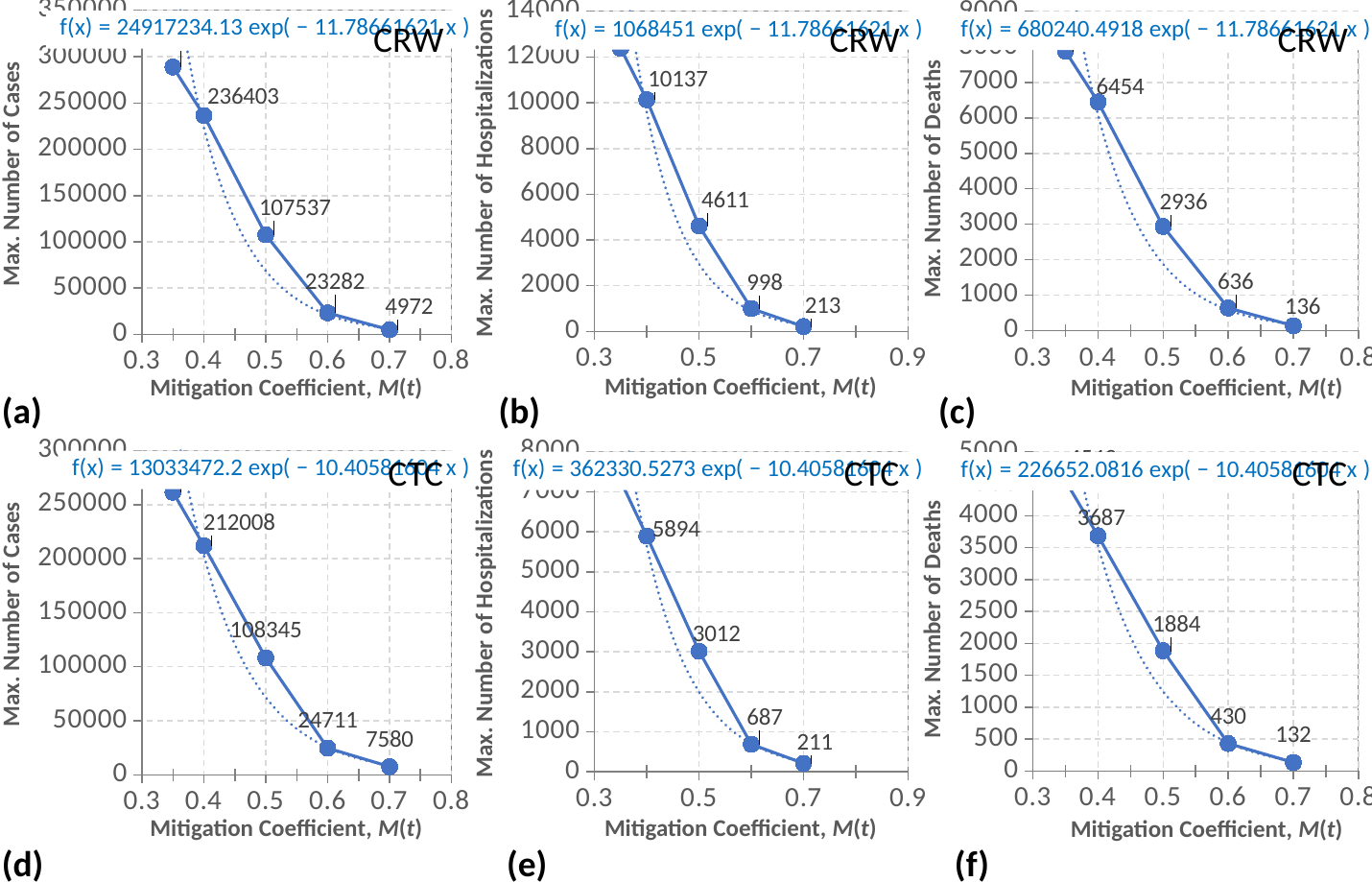
In chart (c), the CRW Max. Number of Deaths chart, what is the value at mitigation coefficient 0.7? 136 In chart (a), the CRW Max. Number of Cases chart, is the value at mitigation coefficient 0.35 greater or less than 250000? greater In chart (c), the CRW Max. Number of Deaths chart, what is the difference between the values at mitigation coefficients 0.4 and 0.5? 3518 In chart (f), the CTC Max. Number of Deaths chart, what is the value at mitigation coefficient 0.5? 1884 In chart (d), the CTC Max. Number of Cases chart, what is the value at mitigation coefficient 0.6? 24711 In chart (e), the CTC Max. Number of Hospitalizations chart, what is the value at mitigation coefficient 0.4? 5894 What is the x-axis label of chart (f), the CTC Max. Number of Deaths chart? Mitigation Coefficient, M(t) In chart (e), the CTC Max. Number of Hospitalizations chart, which is larger: the value at 0.6 or the value at 0.7? 0.6 In chart (d), the CTC Max. Number of Cases chart, do the values rise or fall as the mitigation coefficient increases? fall In chart (b), the CRW Max. Number of Hospitalizations chart, what is the value at mitigation coefficient 0.5? 4611 In chart (a), the CRW Max. Number of Cases chart, what is the value at mitigation coefficient 0.4? 236403 In chart (b), the CRW Max. Number of Hospitalizations chart, how many data points are plotted on the solid line? 5